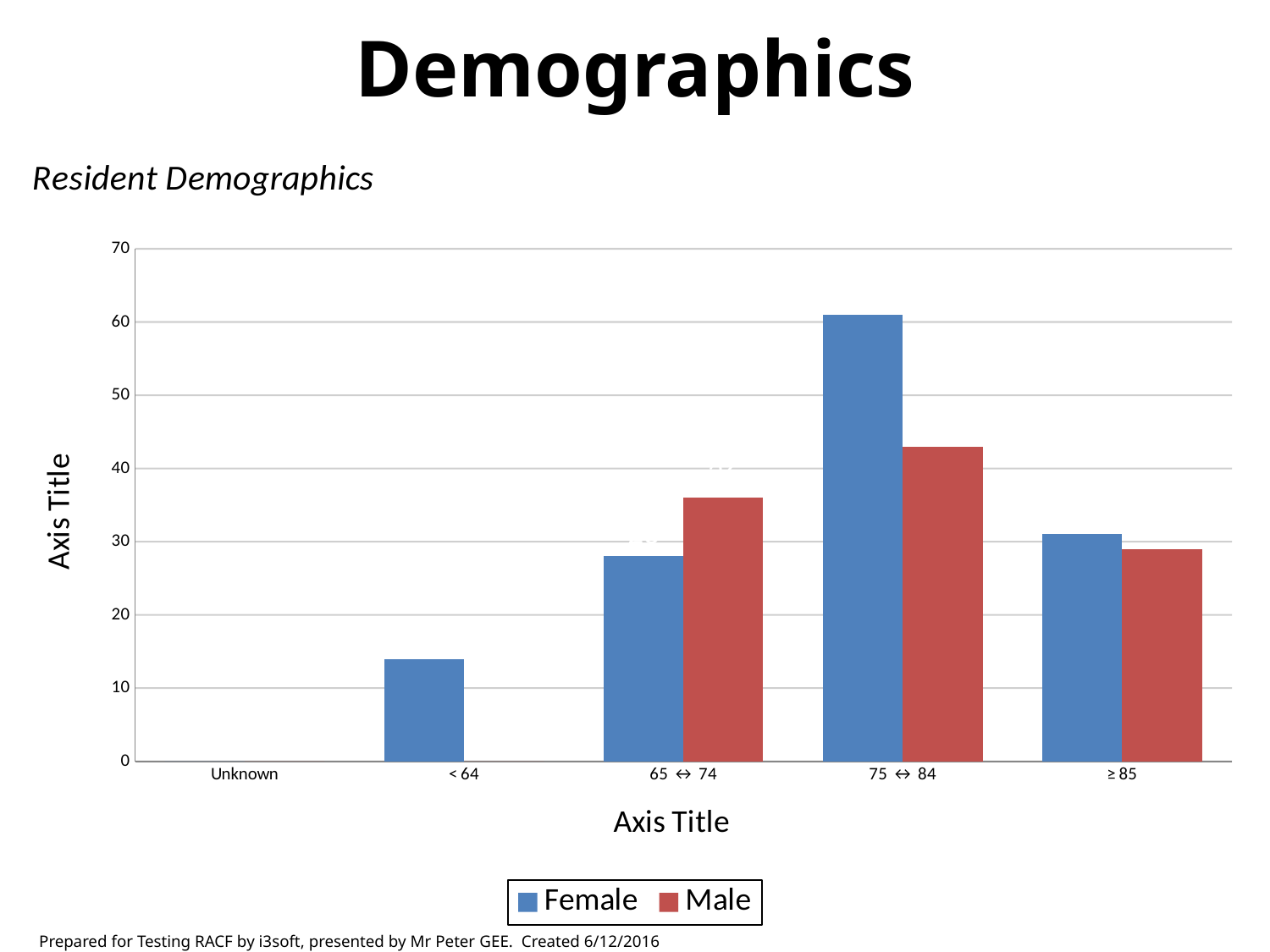
What kind of chart is shown on the slide? bar chart What are the two entries in the legend? Female and Male How many series does the legend list? 2 Which is larger in the 65 ↔ 74 category, the Female value or the Male value? Male Which category has the highest Male value? 75 ↔ 84 Which is larger in the 75 ↔ 84 category, the Female value or the Male value? Female Is the Male value for 65 ↔ 74 greater or less than 30? greater Is the Female value for 75 ↔ 84 greater or less than 50? greater Which category has the highest Female value? 75 ↔ 84 What colour are the Female bars? blue How many categories are shown on the x axis? 5 Is the Male value for 75 ↔ 84 greater or less than 50? less